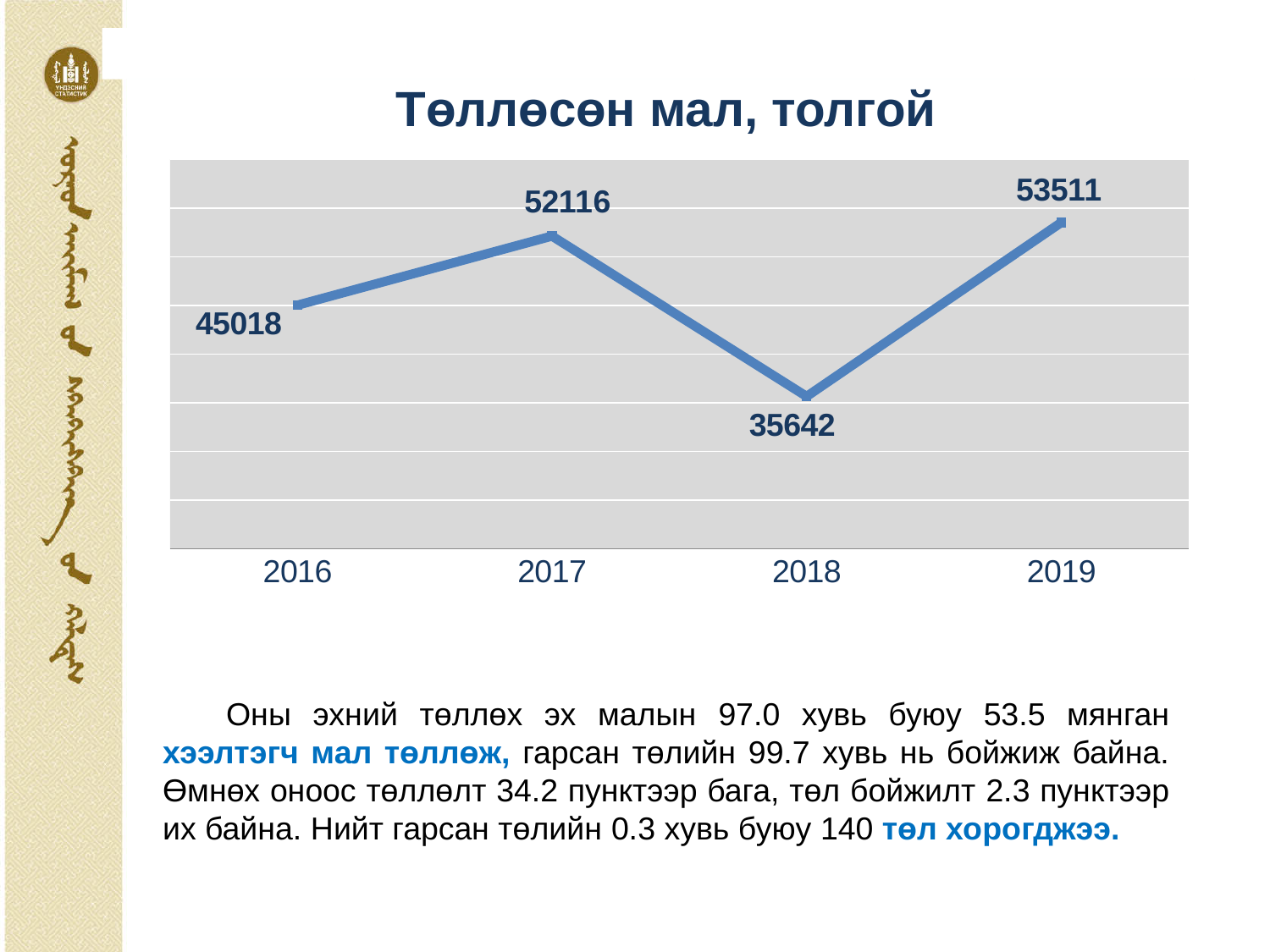
How many years are plotted on the chart? 4 Which year has the lowest value? 2018 Which year has the highest value? 2019 Which is larger, the value for 2016 or the value for 2018? 2016 What is the value for 2018? 35642 What is the value for 2016? 45018 What is the title of the chart? Төллөсөн мал, толгой What is the value for 2017? 52116 What is the difference between the values for 2019 and 2018? 17869 What is the value for 2019? 53511 What is the difference between the values for 2017 and 2016? 7098 What kind of chart is shown on the slide? line chart